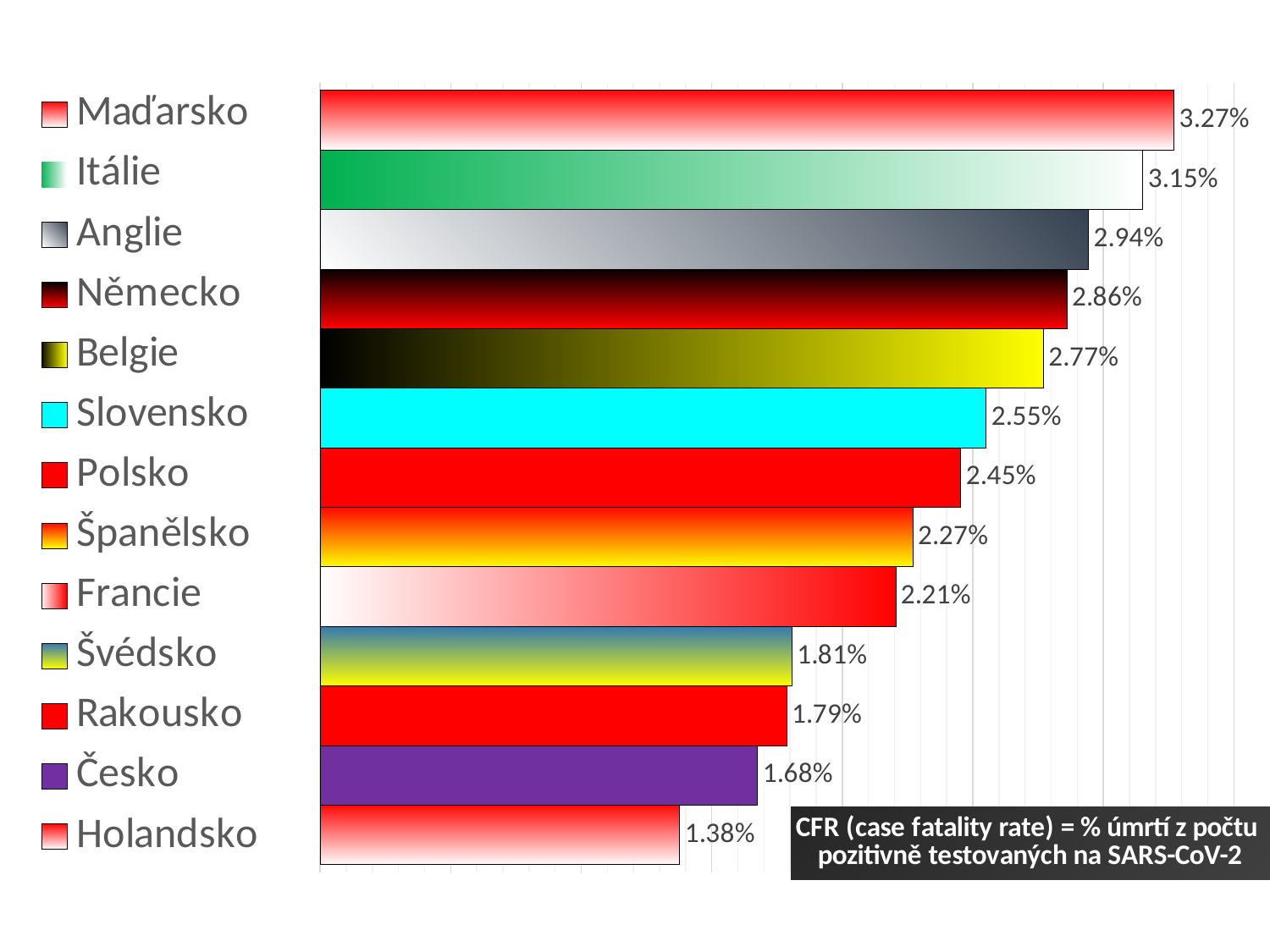
Which has a larger value, Polsko or Francie? Polsko Which country has the highest value on the chart? Maďarsko What is the value shown for Česko? 1.68% What is the difference between the values for Itálie and Anglie? 0.21% How many countries are shown as bars on the chart? 13 What is the difference between the values for Maďarsko and Holandsko? 1.89% Which country has the lowest value on the chart? Holandsko What kind of chart is shown on the slide? Bar chart How many entries does the legend list? 13 According to the text box on the chart, what does CFR stand for? Case fatality rate What is the CFR value shown for Maďarsko? 3.27% What is the value shown for Slovensko? 2.55%